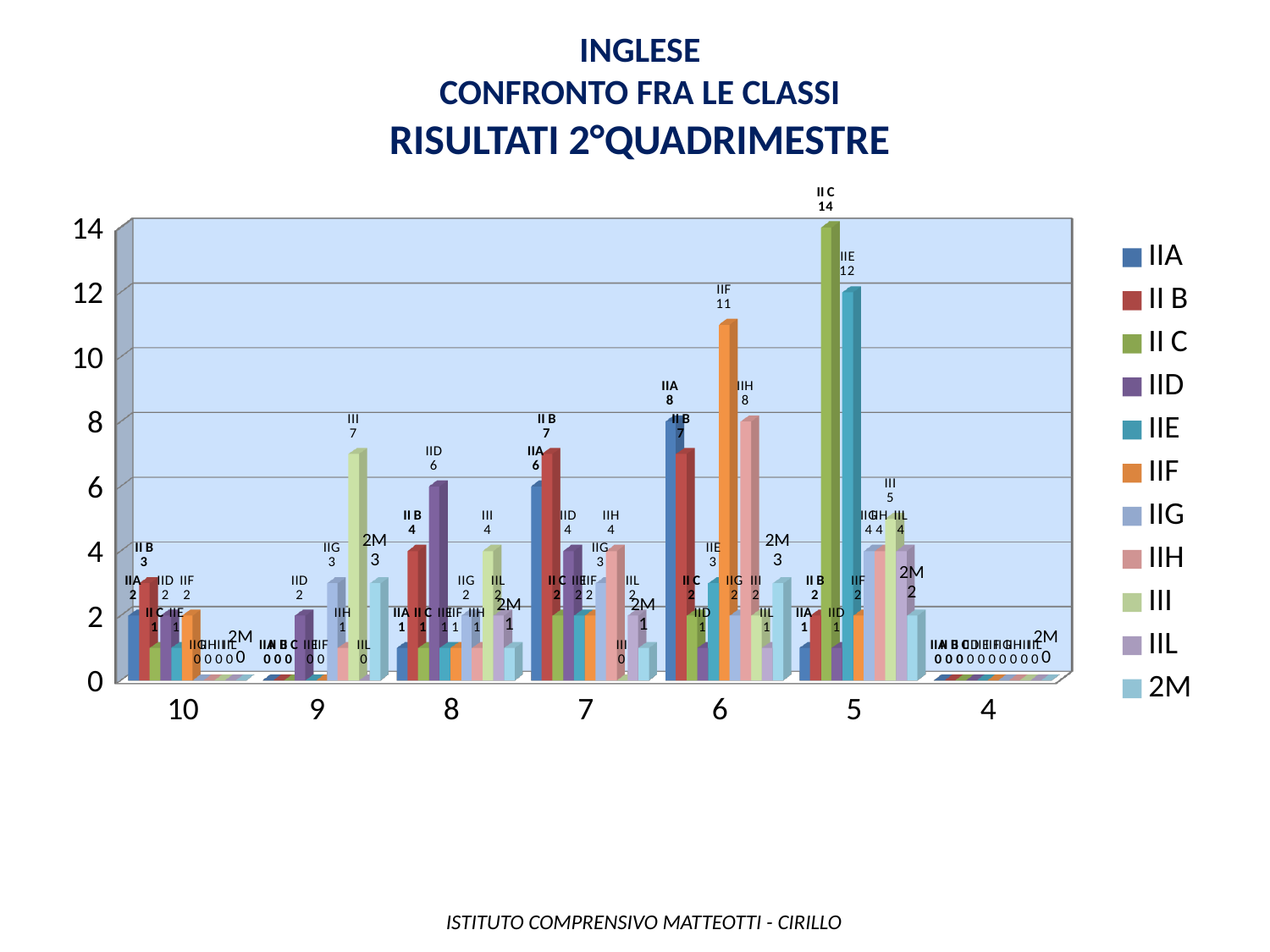
What kind of chart is shown on the slide? bar chart What is the value for IIF at grade 6? 11 Which class has the highest value at grade 6? IIF Which class has the highest value at grade 5? II C What is the value for III at grade 9? 7 What is the value for IID at grade 8? 6 How many series does the legend list? 11 What is the difference between II C and IIE at grade 5? 2 What is the third line of the chart title? RISULTATI 2°QUADRIMESTRE At grade 6, which is larger, IIA or II B? IIA What is the value for II C at grade 5? 14 How many grade categories are shown on the x axis? 7